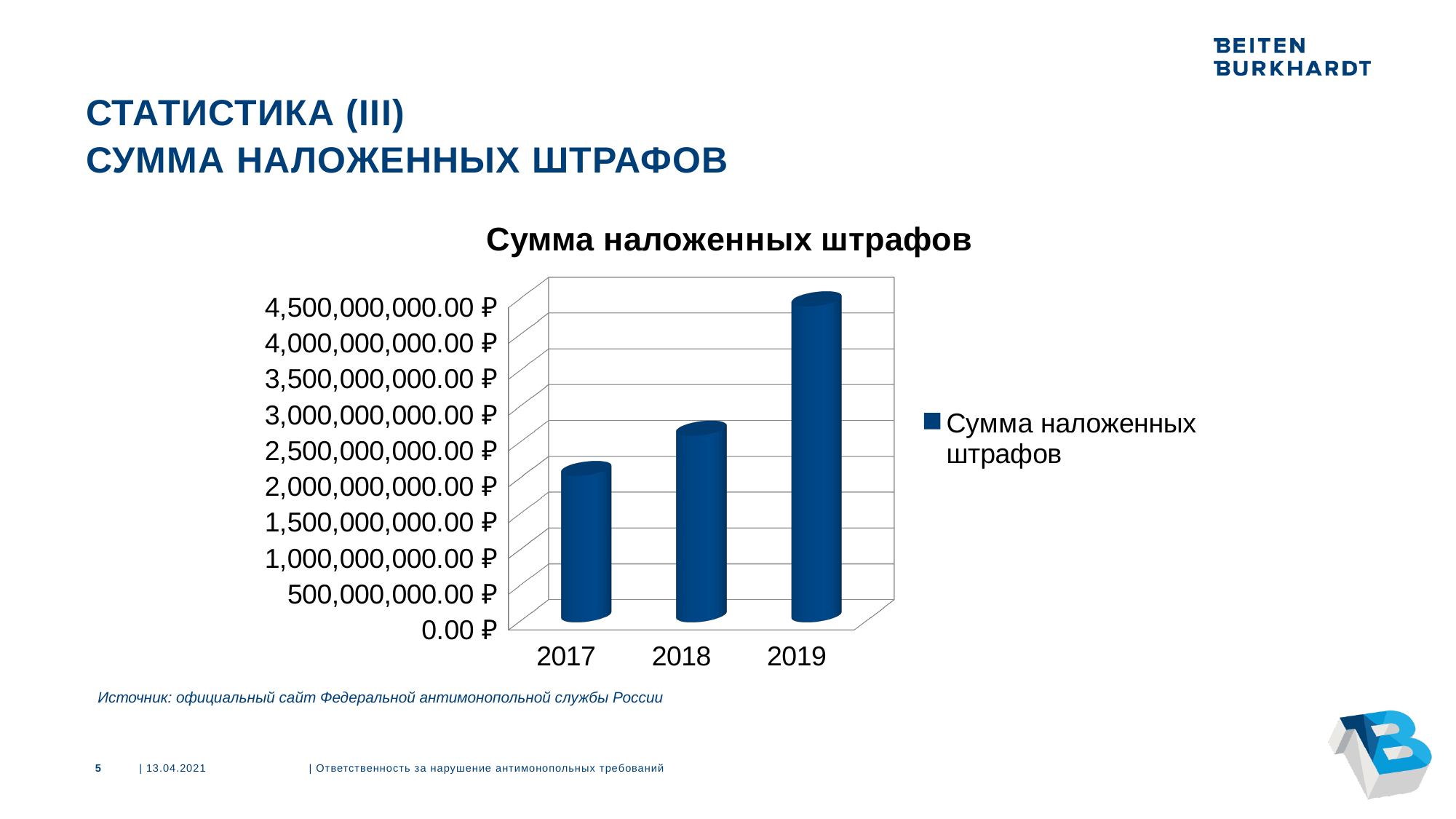
How many series does the chart legend list? 1 Is the value for 2017 greater or less than 2,500,000,000.00 ₽? less Is the value for 2018 greater or less than 2,000,000,000.00 ₽? greater What is the name of the series shown in the legend? Сумма наложенных штрафов Do the values rise or fall from 2017 to 2019? rise Which year has a larger value, 2018 or 2019? 2019 Which year has the lowest sum of imposed fines? 2017 Is the value for 2019 greater or less than 4,000,000,000.00 ₽? greater What kind of chart is shown on the slide? bar chart How many years are shown on the x axis of the chart? 3 Which year has the highest sum of imposed fines? 2019 What is the title of the chart? Сумма наложенных штрафов